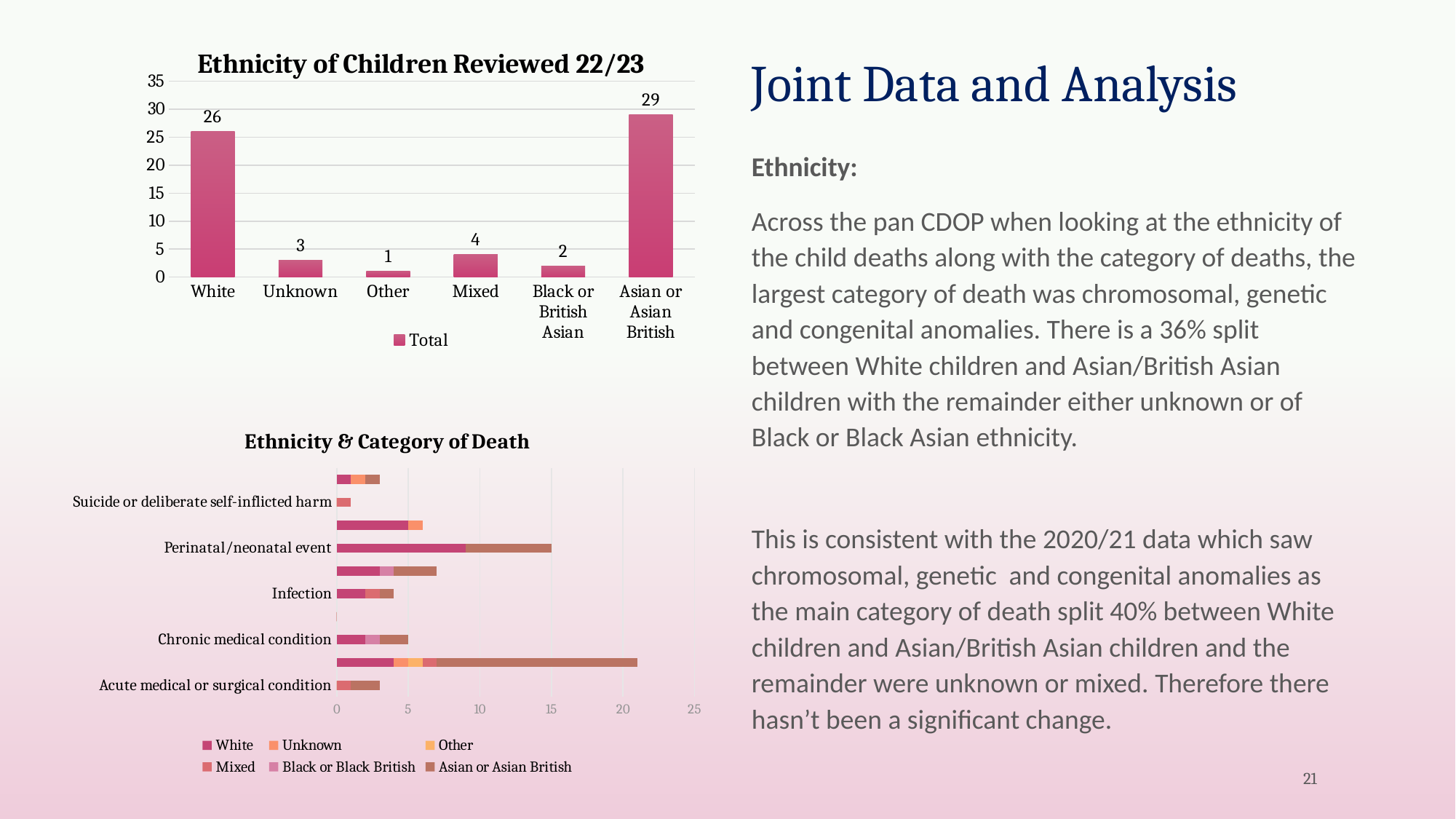
In the 'Ethnicity of Children Reviewed 22/23' chart, what is the value for Mixed? 4 In the 'Ethnicity & Category of Death' chart, is the total bar length for Perinatal/neonatal event greater or less than 10? greater In the 'Ethnicity of Children Reviewed 22/23' chart, which ethnicity has the lowest value? Other What kind of chart is 'Ethnicity & Category of Death'? Stacked bar chart In the 'Ethnicity of Children Reviewed 22/23' chart, which is larger, the value for Unknown or the value for Black or British Asian? Unknown In the 'Ethnicity & Category of Death' chart, is the total bar length for Suicide or deliberate self-inflicted harm greater or less than 5? less How many ethnicity categories are shown in the 'Ethnicity of Children Reviewed 22/23' chart? 6 In the 'Ethnicity of Children Reviewed 22/23' chart, which ethnicity has the highest value? Asian or Asian British In the 'Ethnicity of Children Reviewed 22/23' chart, what is the difference between the values for Asian or Asian British and White? 3 How many series does the legend of the 'Ethnicity & Category of Death' chart list? 6 In the 'Ethnicity of Children Reviewed 22/23' chart, what is the value for White? 26 In the 'Ethnicity of Children Reviewed 22/23' chart, what is the value for Asian or Asian British? 29